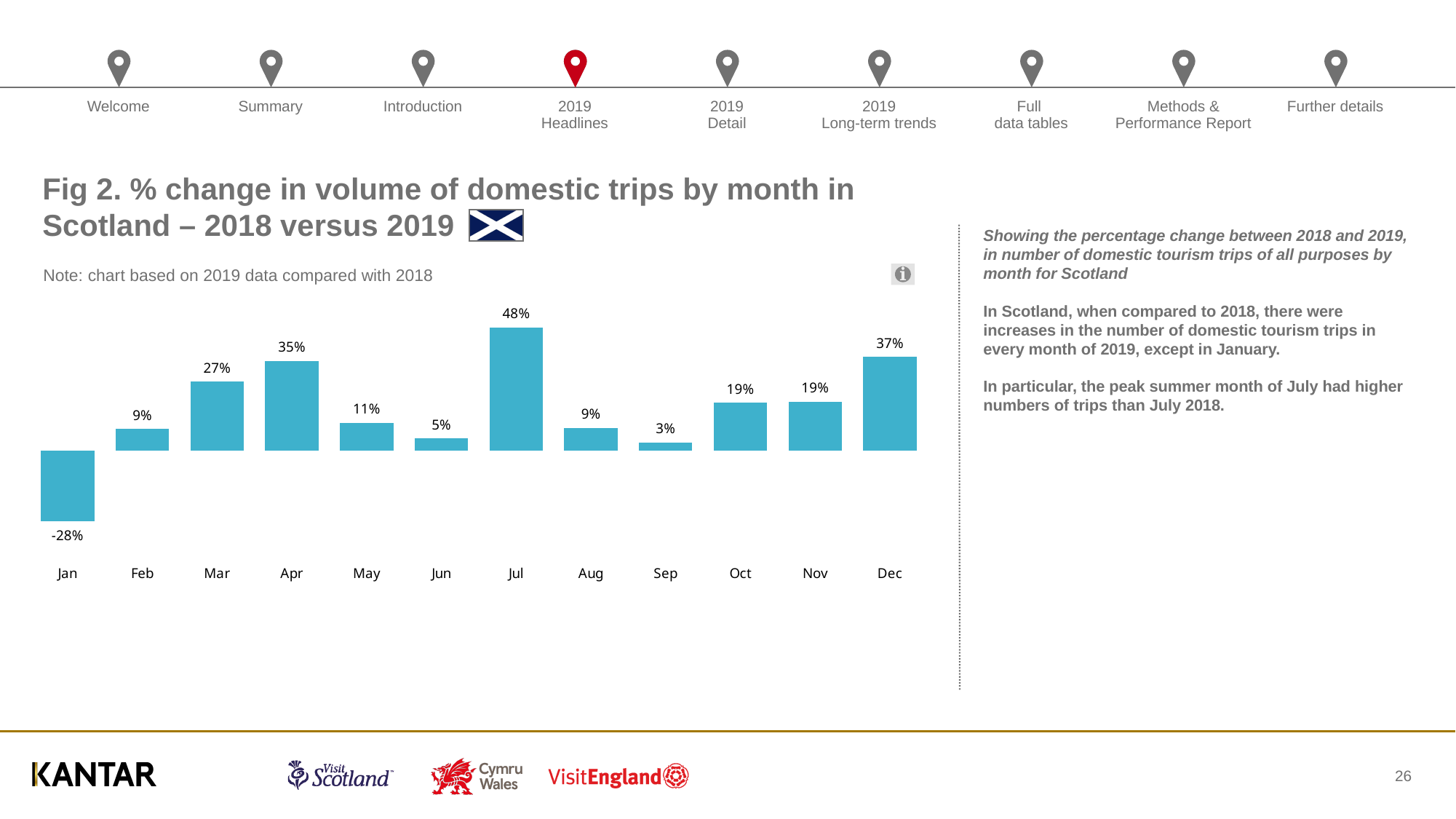
What colour are the bars in the chart? Blue How many months are shown on the chart? 12 What is the % change in volume of domestic trips for December? 37% What is the difference between the % change for July and the % change for April? 13 percentage points Which month has a larger % change, March or May? Mar Which two months both show a % change of 19%? Oct and Nov What kind of chart is shown on the slide? Bar chart Which month has the highest % change in volume of domestic trips? Jul How many months show a negative % change? 1 Which month has the lowest % change in volume of domestic trips? Jan What is the % change in volume of domestic trips for January? -28% What is the % change in volume of domestic trips for July? 48%